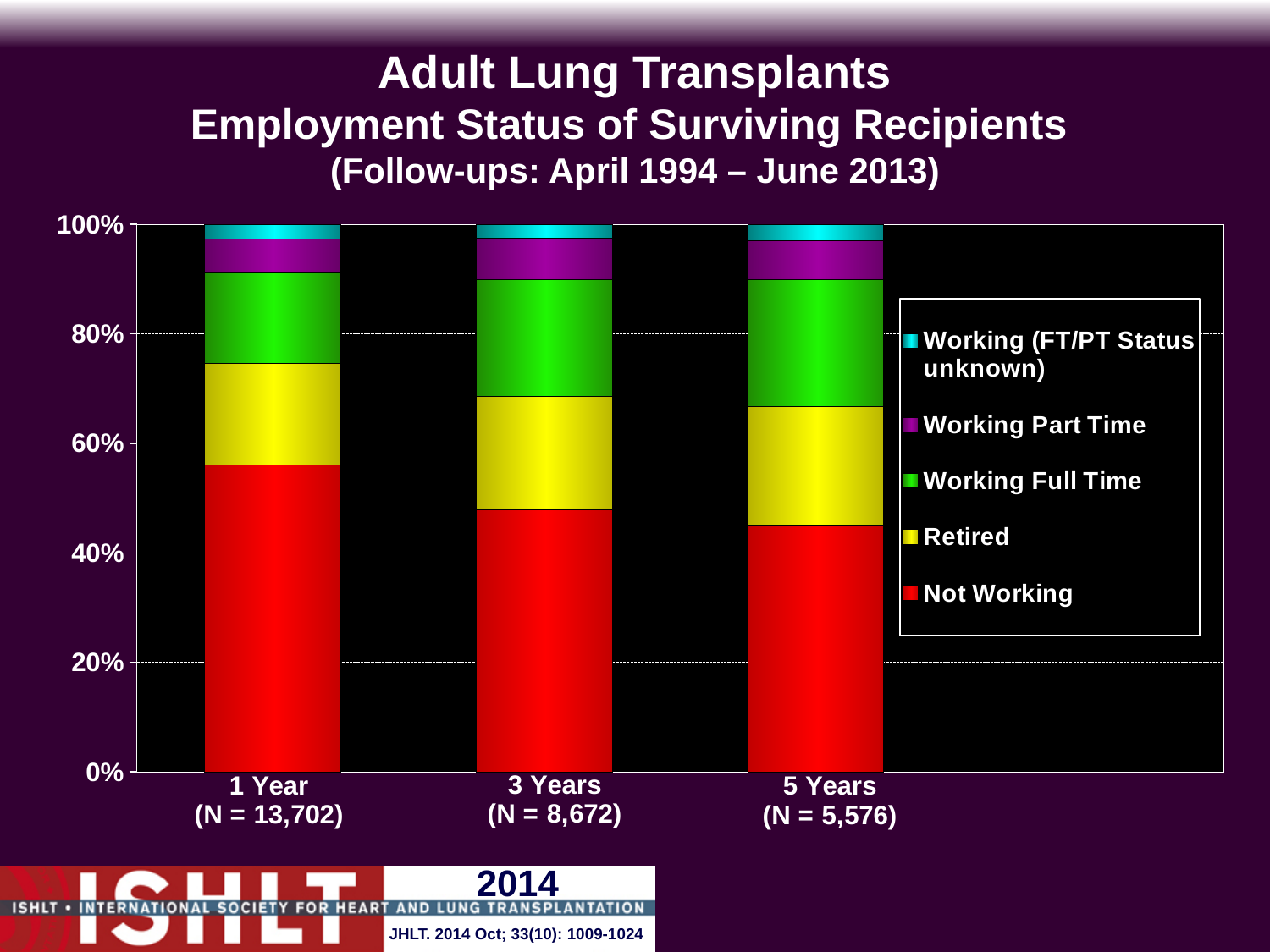
Is the Not Working share at 1 Year greater or less than 40%? greater What is the N value shown for the 1 Year category? N = 13,702 What is the N value shown for the 5 Years category? N = 5,576 What is the total height of each stacked bar? 100% Which follow-up category has the largest Not Working segment? 1 Year How many follow-up time categories are shown on the x axis? 3 Is the Not Working segment larger at 1 Year or at 5 Years? 1 Year What kind of chart is shown on the slide? Stacked bar chart Which colour represents Retired in the legend? Yellow Is the Not Working share at 5 Years greater or less than 60%? less Does the Not Working share rise or fall from 1 Year to 5 Years? Fall How many series does the legend list? 5